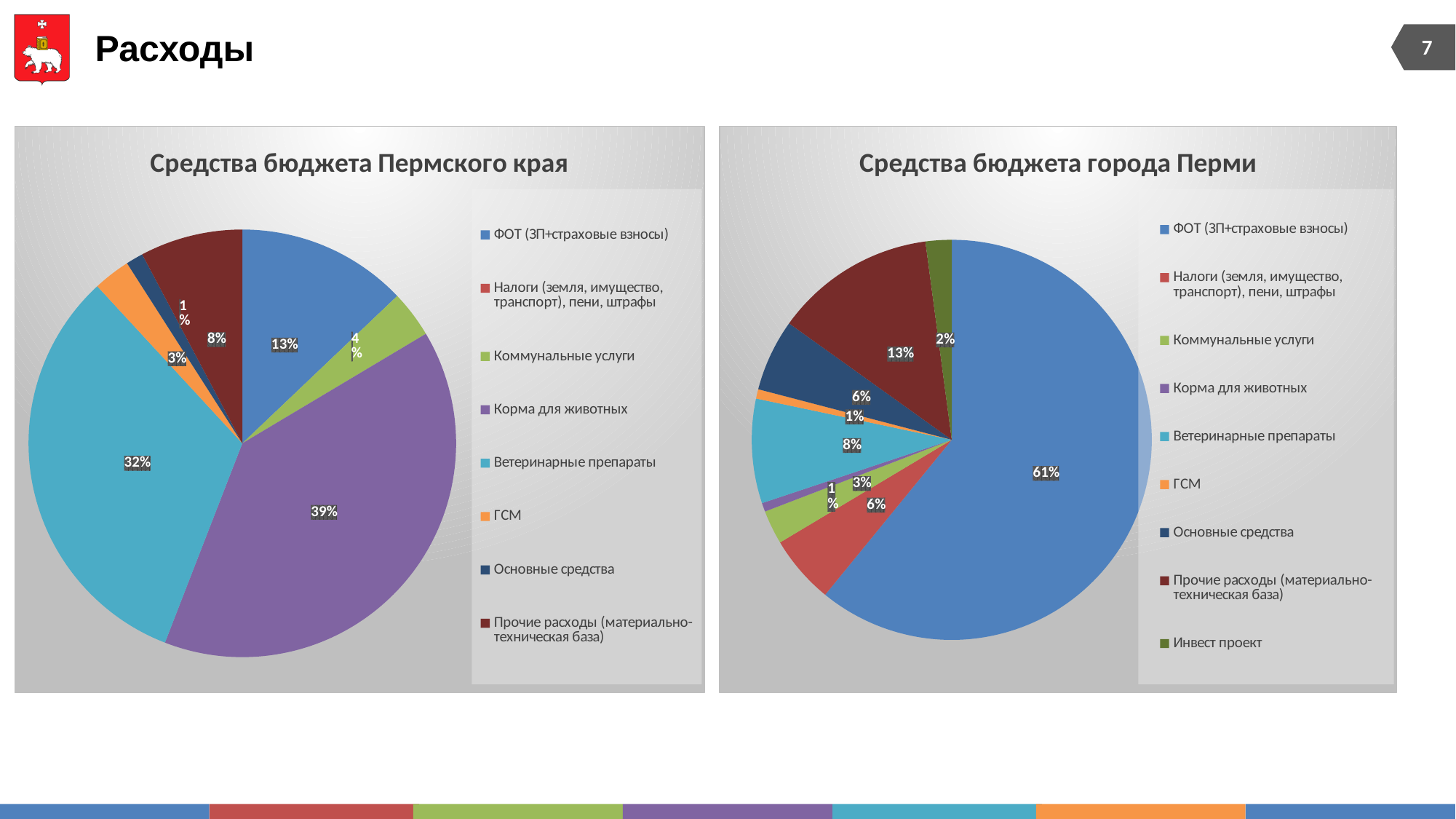
On the chart titled "Средства бюджета Пермского края", how many entries does the legend list? 8 On the chart titled "Средства бюджета Пермского края", what share does "Ветеринарные препараты" have? 32% On the chart titled "Средства бюджета города Перми", what share does "ФОТ (ЗП+страховые взносы)" have? 61% On the chart titled "Средства бюджета Пермского края", what is the difference between the shares of "ФОТ (ЗП+страховые взносы)" and "Прочие расходы (материально-техническая база)"? 5% On the chart titled "Средства бюджета города Перми", what share does "Инвест проект" have? 2% On the chart titled "Средства бюджета города Перми", which is larger: the share of "Ветеринарные препараты" or the share of "Коммунальные услуги"? Ветеринарные препараты On the chart titled "Средства бюджета города Перми", how many entries does the legend list? 9 What is the title of the chart on the left side of the slide? Средства бюджета Пермского края On the chart titled "Средства бюджета Пермского края", which category has the largest slice? Корма для животных What kind of chart is "Средства бюджета города Перми"? Pie chart